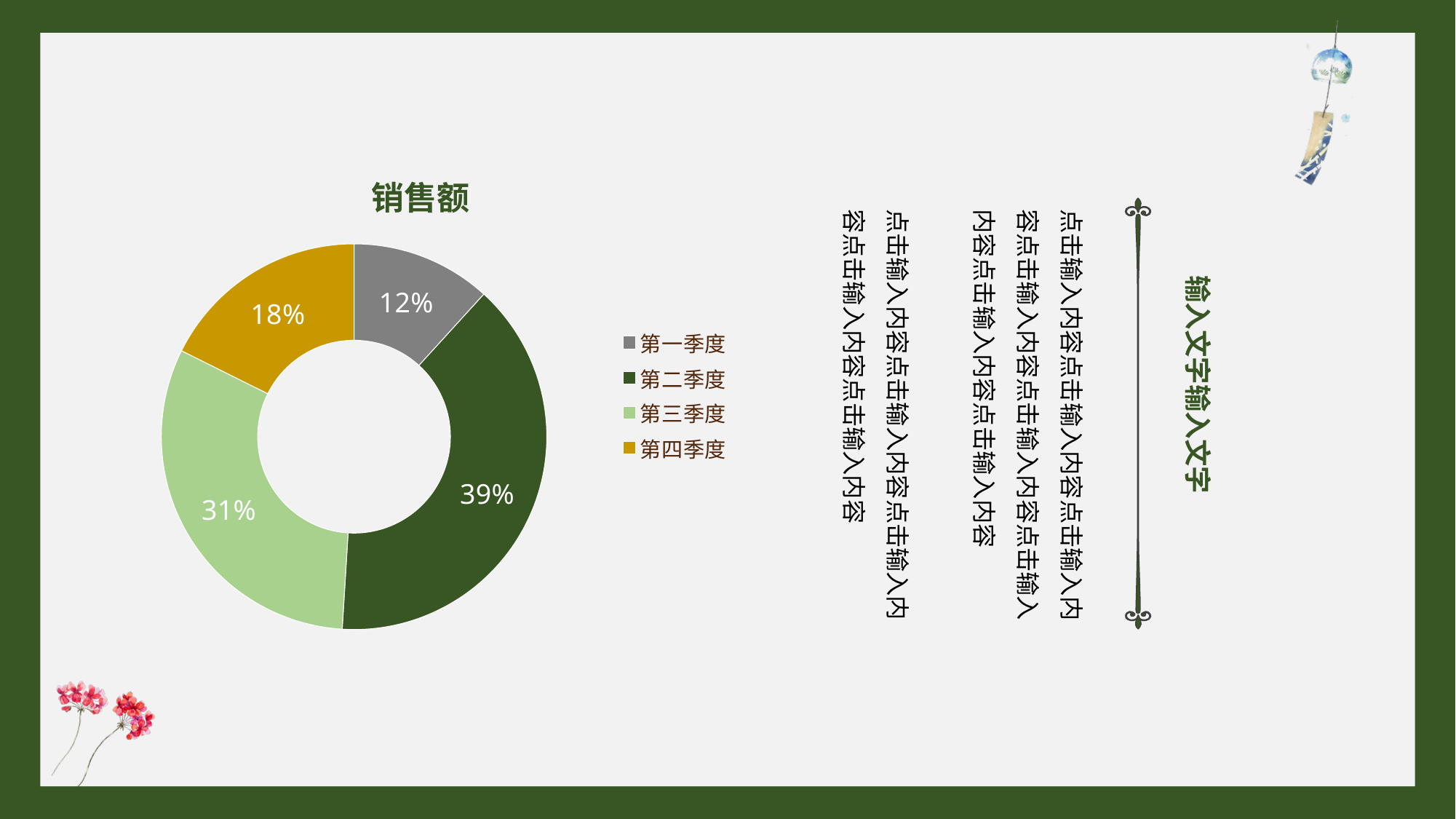
What is the difference in percentage points between 第二季度 and 第三季度? 8 What colour is the slice for 第四季度? Gold (dark yellow) Which quarter has the largest share of the chart? 第二季度 Which is larger, the share for 第四季度 or the share for 第一季度? 第四季度 What percentage is shown for 第三季度? 31% What percentage is shown for 第一季度? 12% What is the title of the chart? 销售额 What kind of chart is shown on the slide? Doughnut (pie) chart How many categories does the legend list? 4 What percentage is shown for 第二季度? 39% Which quarter has the smallest share of the chart? 第一季度 What percentage is shown for 第四季度? 18%